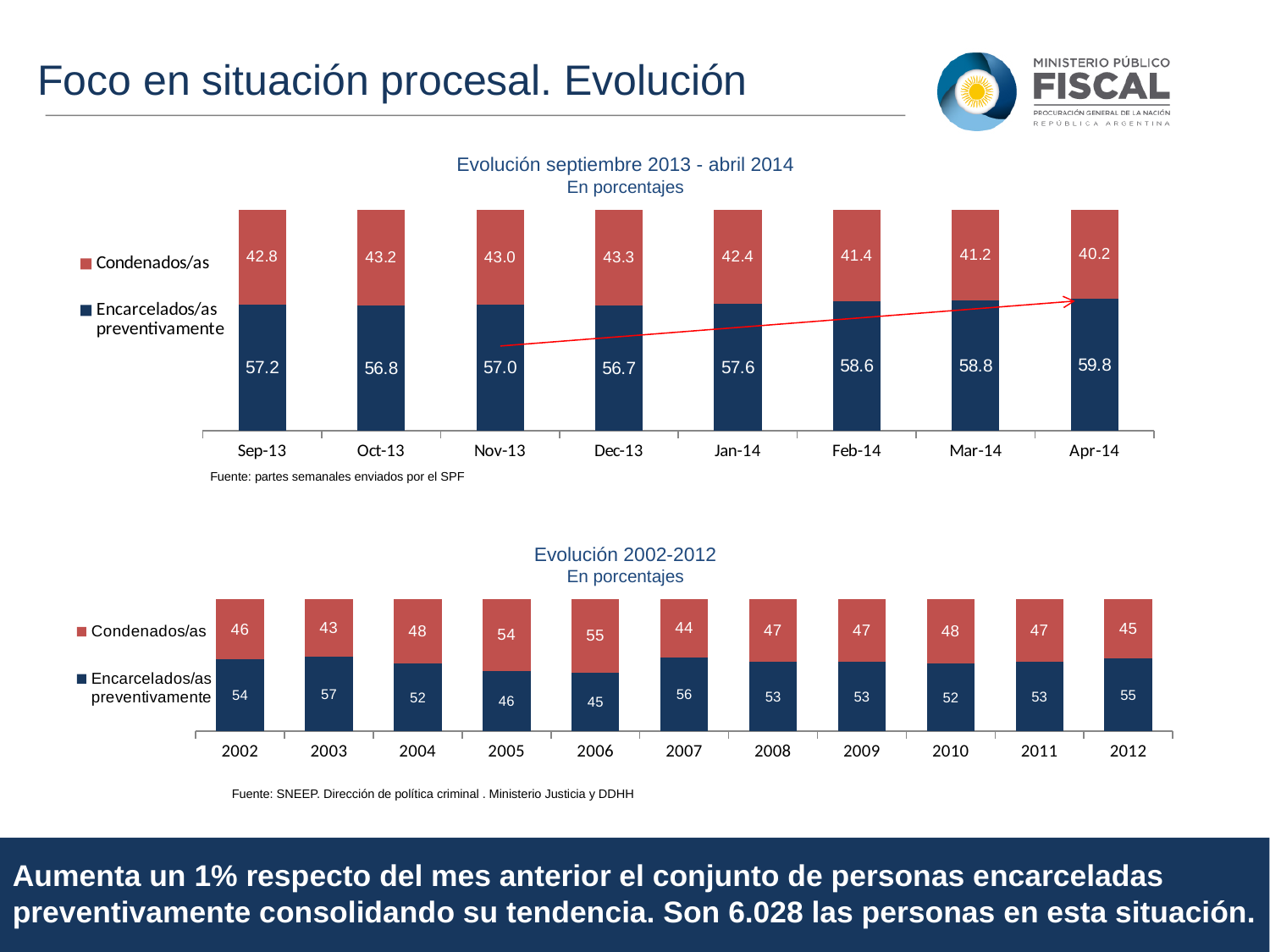
In the chart titled 'Evolución septiembre 2013 - abril 2014', does the Encarcelados/as preventivamente series generally rise or fall from Sep-13 to Apr-14? rise In the chart titled 'Evolución septiembre 2013 - abril 2014', what is the value for Encarcelados/as preventivamente in Apr-14? 59.8 In the chart titled 'Evolución 2002-2012', what is the value for Condenados/as in 2006? 55 In the chart titled 'Evolución 2002-2012', which year has the highest value for Encarcelados/as preventivamente? 2003 In the chart titled 'Evolución septiembre 2013 - abril 2014', which month has the highest value for Encarcelados/as preventivamente? Apr-14 In the chart titled 'Evolución septiembre 2013 - abril 2014', what is the value for Condenados/as in Dec-13? 43.3 In the chart titled 'Evolución 2002-2012', which year has the lowest value for Encarcelados/as preventivamente? 2006 In the chart titled 'Evolución 2002-2012', is the Encarcelados/as preventivamente value for 2007 larger or smaller than the value for 2005? larger In the chart titled 'Evolución septiembre 2013 - abril 2014', what is the difference between the Encarcelados/as preventivamente values for Apr-14 and Sep-13? 2.6 In the chart titled 'Evolución septiembre 2013 - abril 2014', which month has the lowest value for Condenados/as? Apr-14 In the chart titled 'Evolución septiembre 2013 - abril 2014', how many months are shown on the x axis? 8 In the chart titled 'Evolución 2002-2012', how many series does the legend list? 2